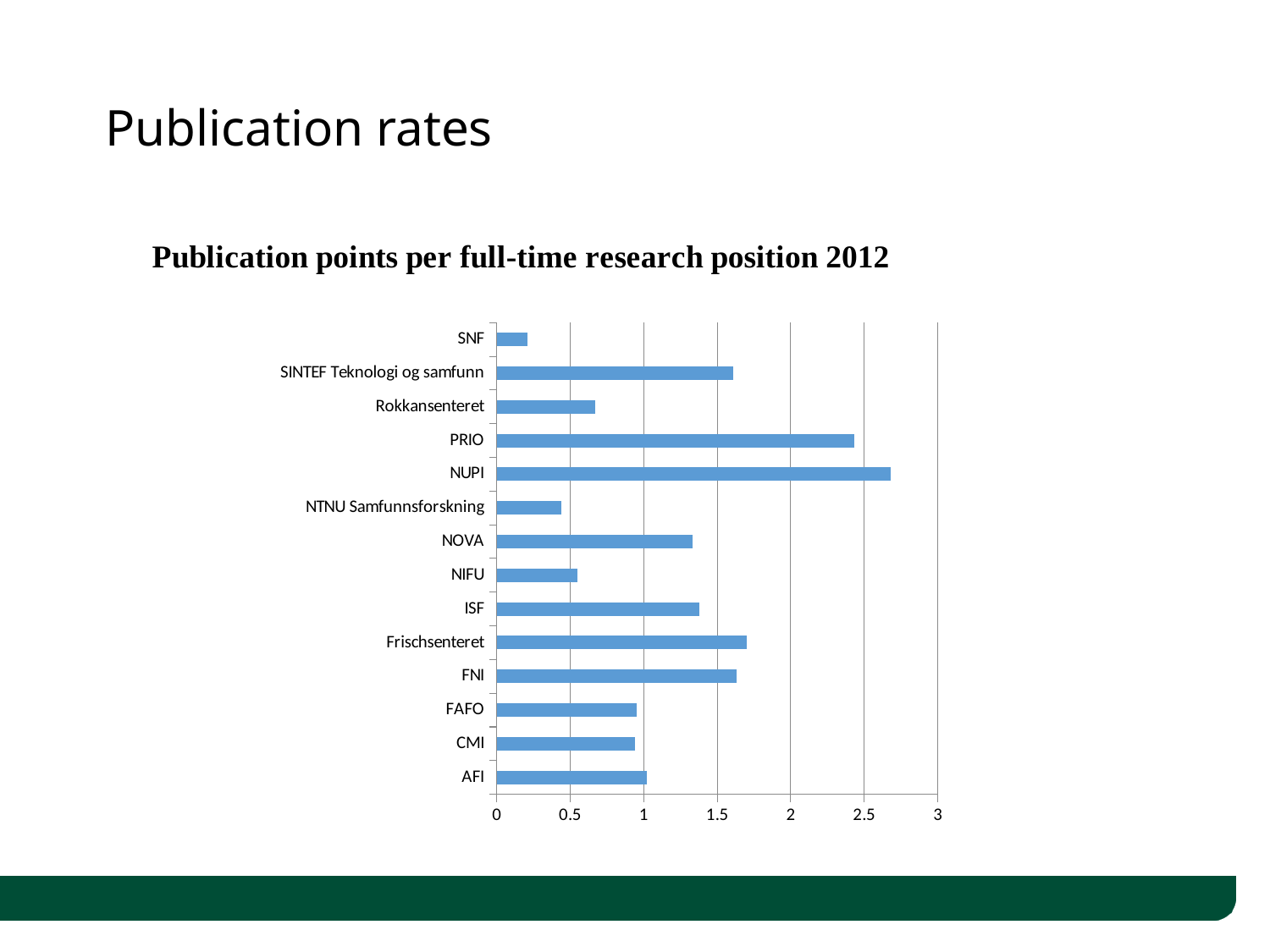
Is the value for SNF greater or less than 0.5? less What is the title of the chart? Publication points per full-time research position 2012 Is the value for SINTEF Teknologi og samfunn greater or less than 1.5? greater Which has a higher value, PRIO or Rokkansenteret? PRIO Which institution has the lowest publication points per full-time research position? SNF Which institution has the highest publication points per full-time research position? NUPI Which has a higher value, Frischsenteret or NOVA? Frischsenteret Is the value for NUPI greater or less than 2.5? greater How many institutions are listed on the chart? 14 What kind of chart is shown on the slide? Bar chart